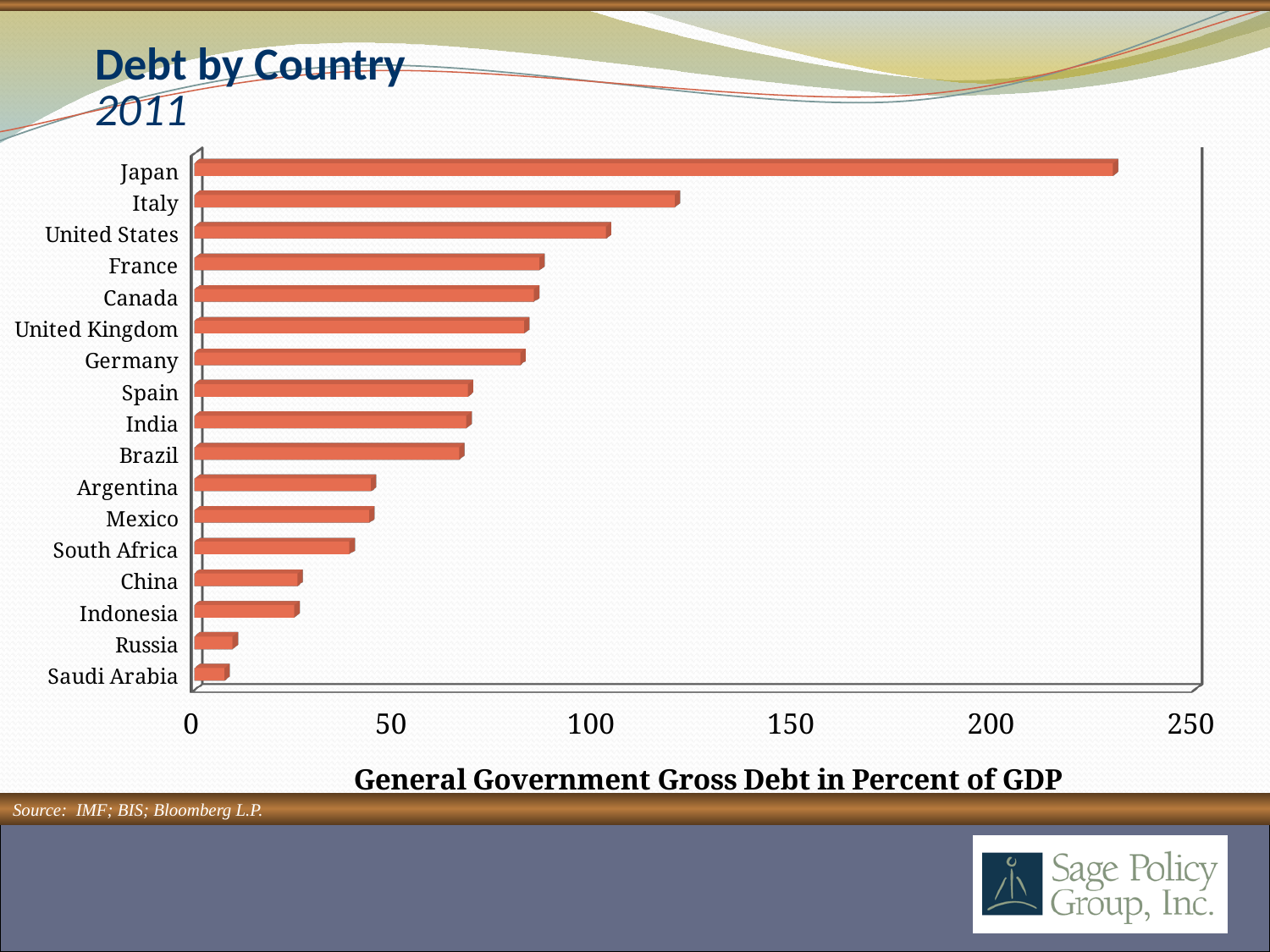
Which has a larger value, Brazil or Argentina? Brazil What kind of chart is shown on the slide? bar chart Is the value for China greater or less than 50? less Which has a larger value, Italy or United States? Italy Is the value for United States greater or less than 150? less Is the value for France greater or less than 100? less What is the label on the horizontal axis of the chart? General Government Gross Debt in Percent of GDP How many countries are shown in the chart? 17 Which country has the highest general government gross debt in percent of GDP? Japan